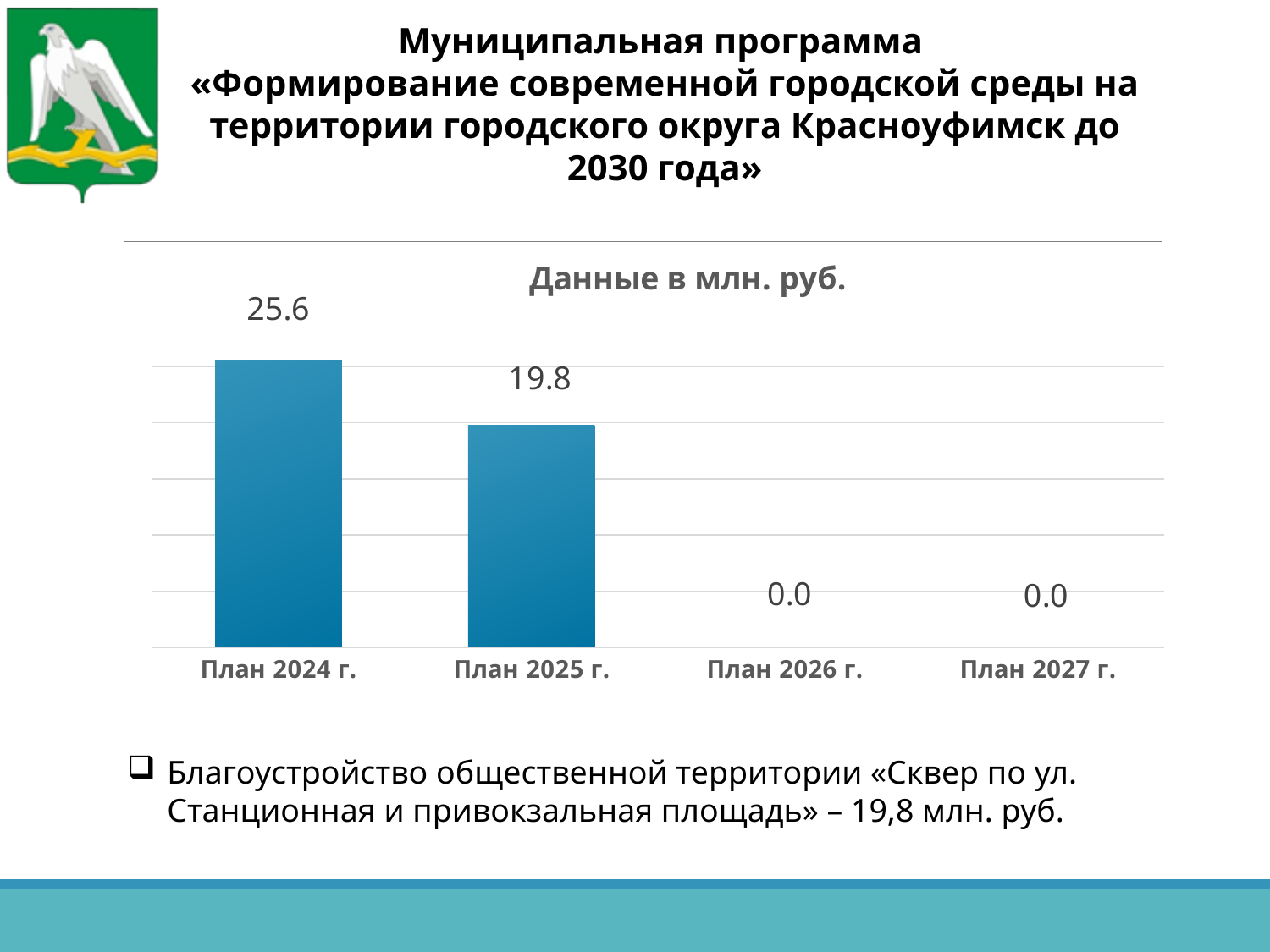
What is the value for План 2025 г.? 19.8 What is the total of the values for План 2024 г. and План 2025 г.? 45.4 How many categories are shown on the x axis? 4 What is the value for План 2026 г.? 0.0 What is the value for План 2024 г.? 25.6 What is the title of the chart? Данные в млн. руб. What kind of chart is shown on the slide? Bar chart Which category has the highest value? План 2024 г. Which is larger, the value for План 2024 г. or the value for План 2025 г.? План 2024 г. What is the difference between the values for План 2024 г. and План 2025 г.? 5.8 What is the value for План 2027 г.? 0.0 Do the values rise or fall from План 2024 г. to План 2027 г.? Fall